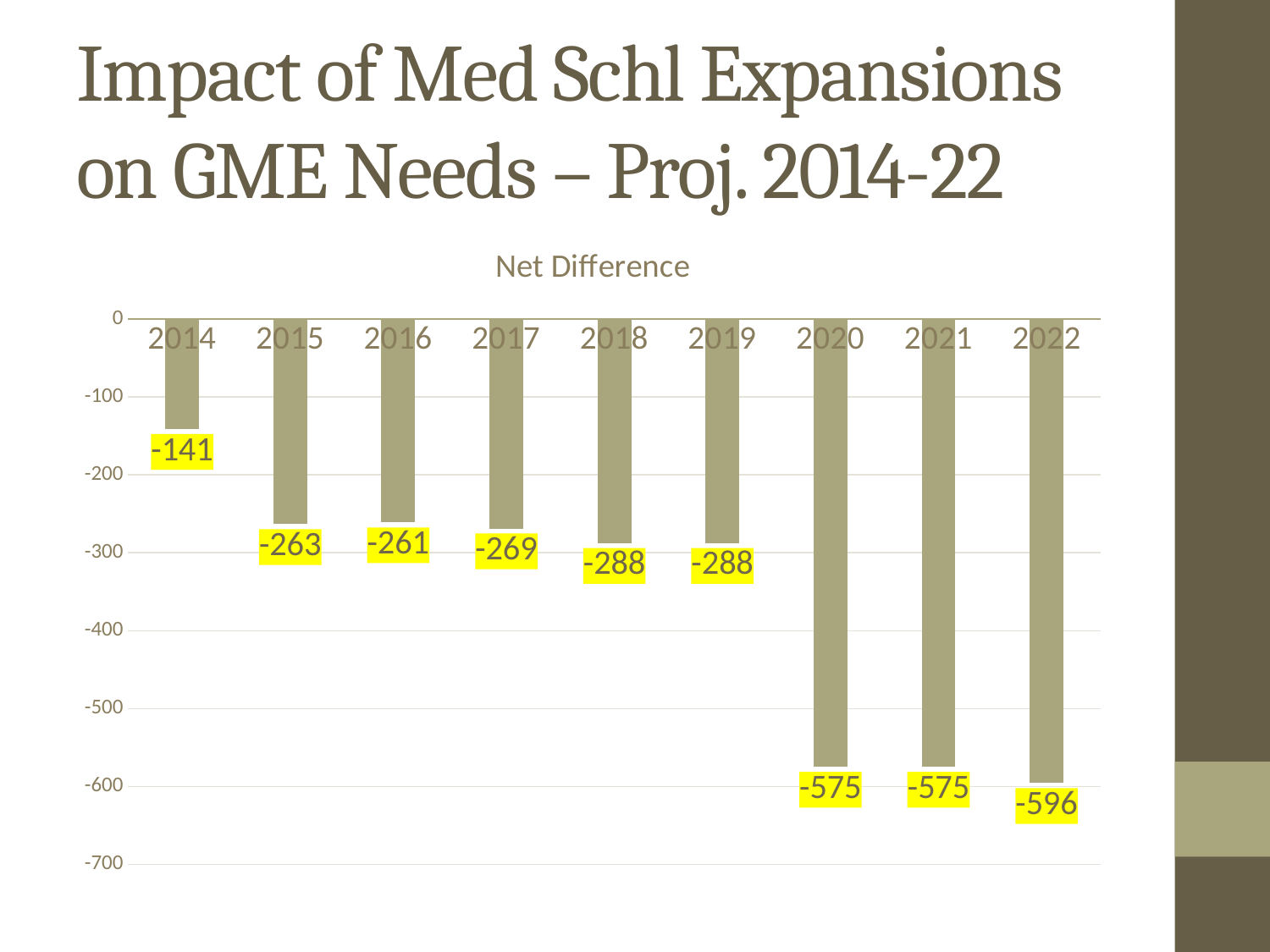
Which year has a more negative Net Difference value, 2016 or 2018? 2018 What kind of chart is shown on the slide? Bar chart What is the Net Difference value for 2014? -141 Which year has the lowest (most negative) Net Difference value? 2022 Do the Net Difference values generally rise or fall from 2014 to 2022? Fall What is the Net Difference value for 2022? -596 Which year has the highest (least negative) Net Difference value? 2014 How many years are shown on the x axis of the chart? 9 What is the Net Difference value for 2017? -269 What is the difference between the Net Difference values for 2019 and 2020? 287 What is the difference between the Net Difference values for 2014 and 2015? 122 What is the title of the chart? Net Difference